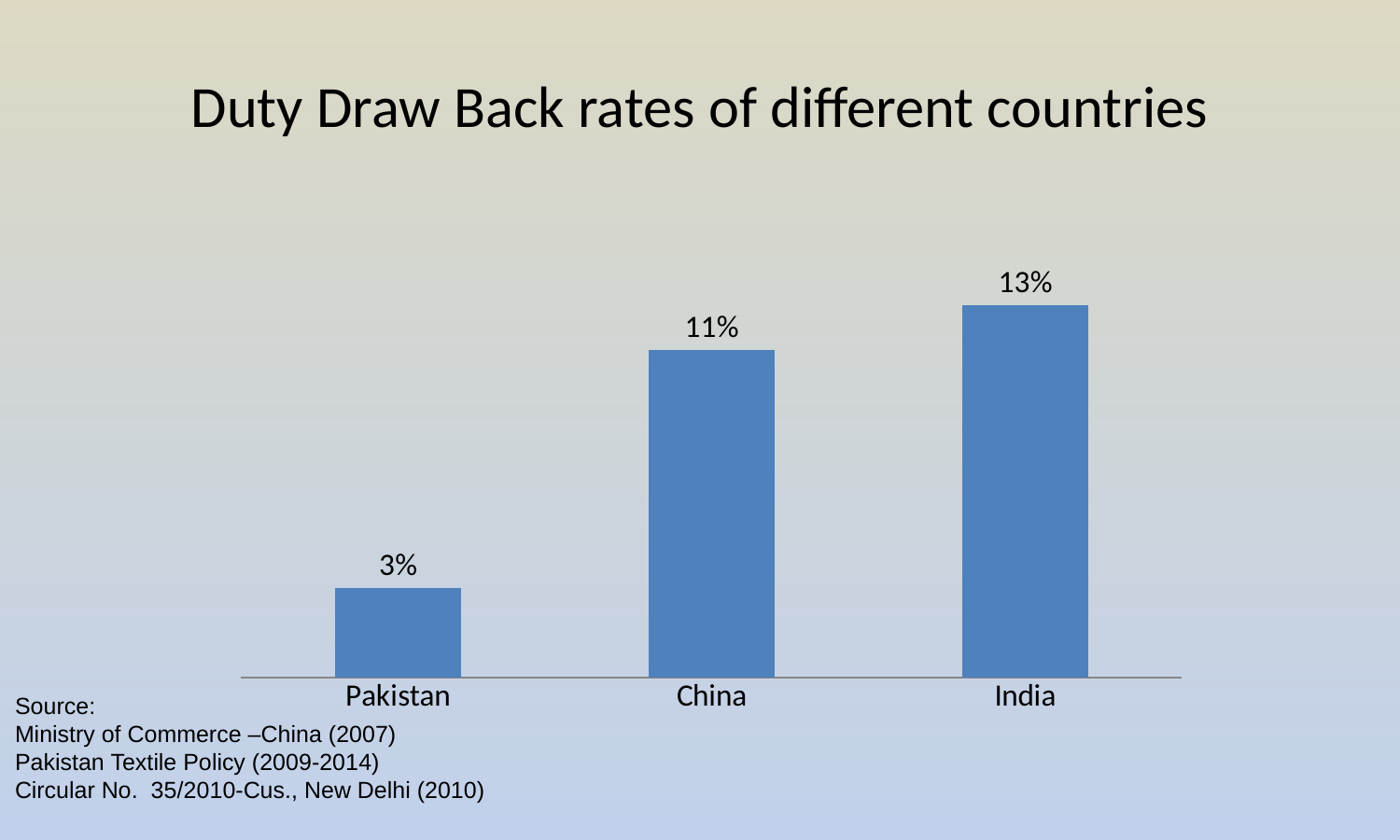
Which country has the highest duty draw back rate? India What is the duty draw back rate for China? 11% What is the difference between India's and Pakistan's duty draw back rates? 10% What kind of chart is shown on the slide? Bar chart What is the title of the chart? Duty Draw Back rates of different countries How many countries are shown in the chart? 3 Do the values rise or fall from Pakistan to India along the x axis? Rise Which has a higher duty draw back rate, China or Pakistan? China Which country has the lowest duty draw back rate? Pakistan What is the duty draw back rate for Pakistan? 3% What is the duty draw back rate for India? 13% What is the difference between India's and China's duty draw back rates? 2%